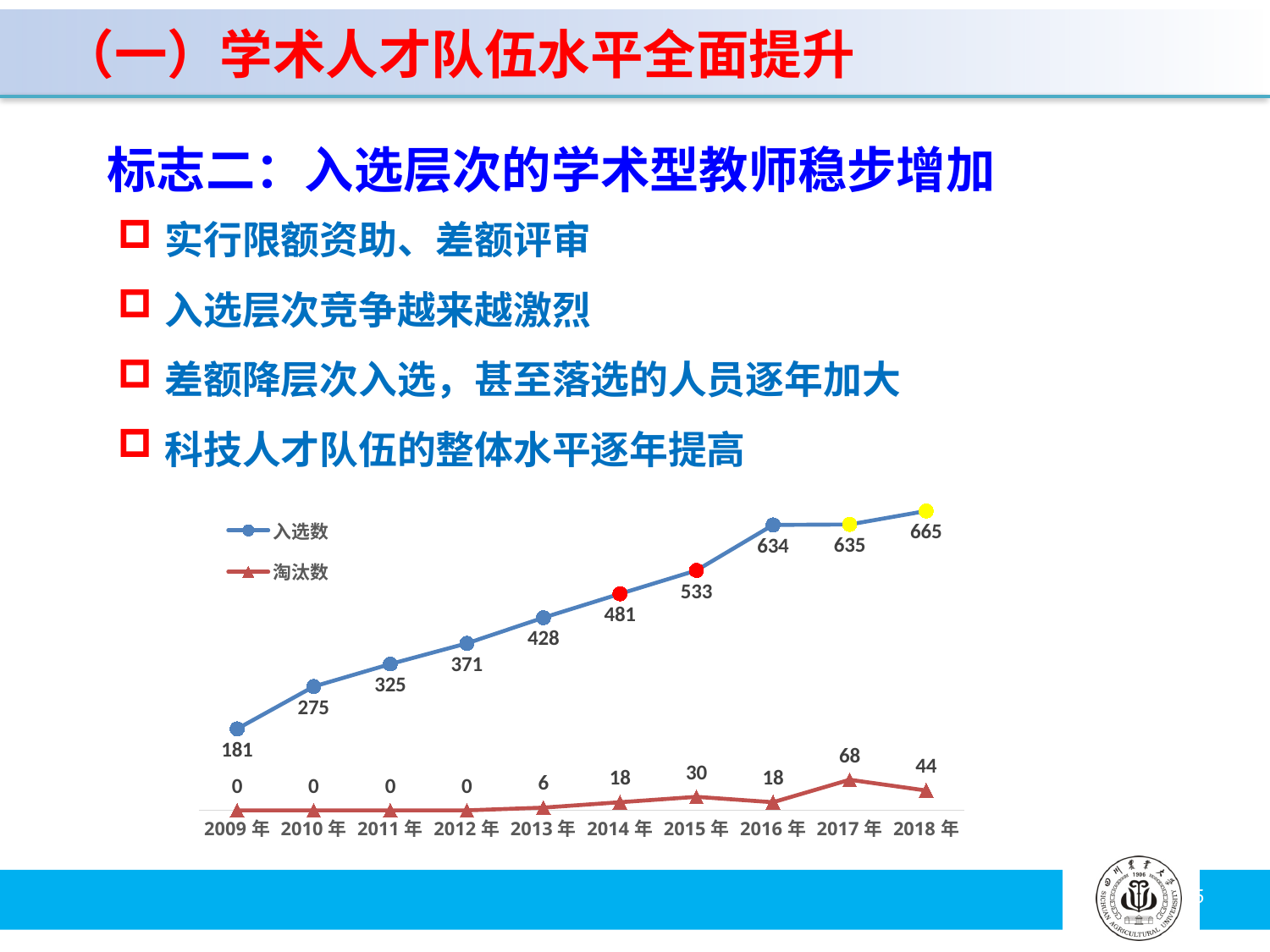
What is the 入选数 value for 2014年? 481 What kind of chart is this? line chart In which year is 入选数 highest? 2018年 What is the difference between 淘汰数 in 2017年 and 2018年? 24 What is the 淘汰数 value for 2017年? 68 In which year is 淘汰数 highest? 2017年 How many years are shown on the x axis? 10 What is the 入选数 value for 2009年? 181 Which is larger, 淘汰数 in 2015年 or 淘汰数 in 2016年? 2015年 Does 入选数 rise or fall from 2009年 to 2018年? rise What is the difference between 入选数 in 2018年 and 2017年? 30 How many series does the legend list? 2